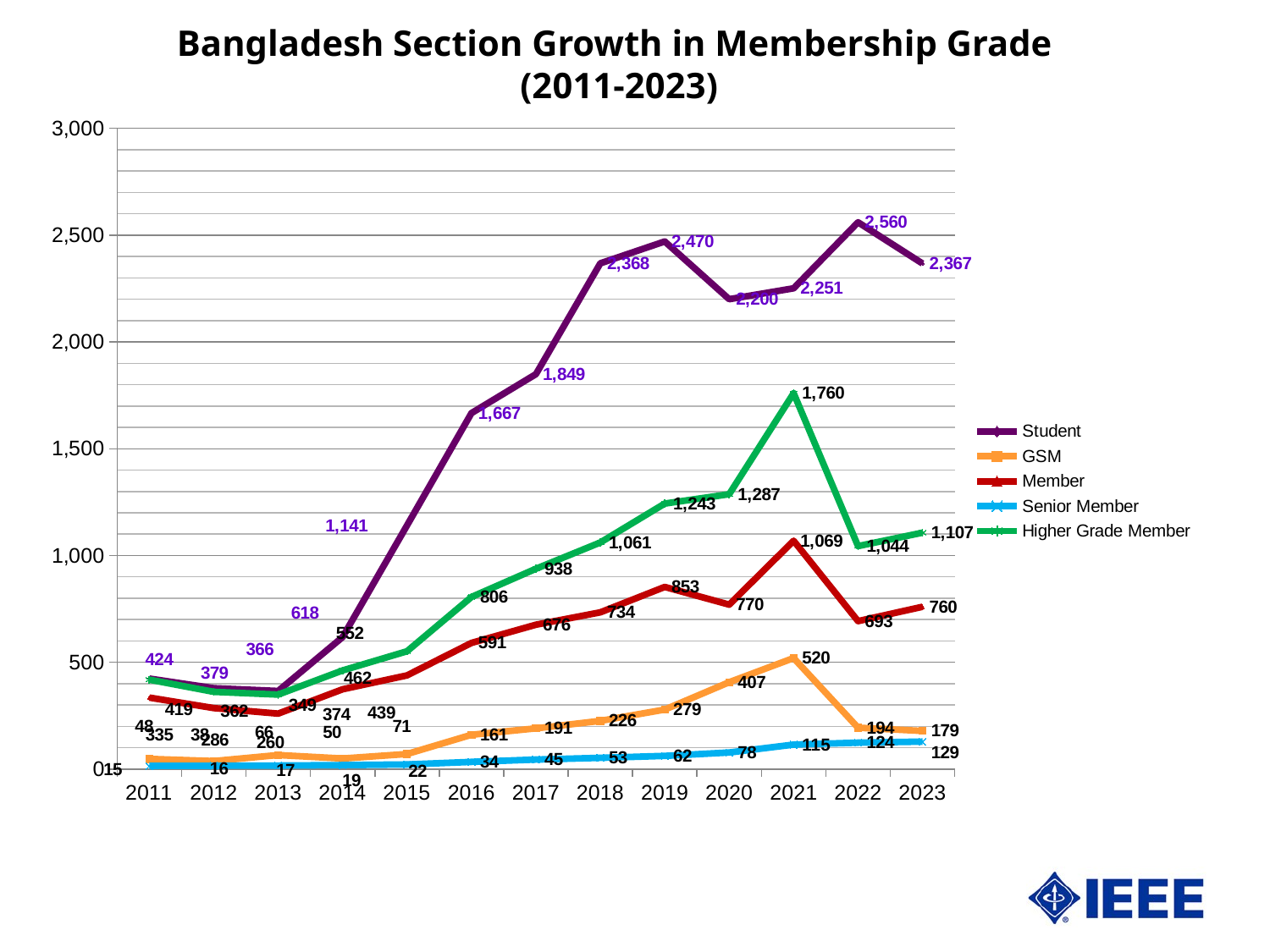
What is the Higher Grade Member value for 2021? 1,760 How many series does the legend list? 5 What type of chart is shown on the slide? line chart Which is larger in 2019, the Higher Grade Member value or the Member value? Higher Grade Member In which year does the Student series reach its highest value? 2022 What is the GSM value for 2020? 407 What is the Student value for 2022? 2,560 What is the Senior Member value for 2023? 129 In which year is the Senior Member series lowest? 2011 Is the Student value for 2017 greater or less than 2,000? less What is the difference between the Member values for 2021 and 2022? 376 How many years are plotted along the x axis? 13